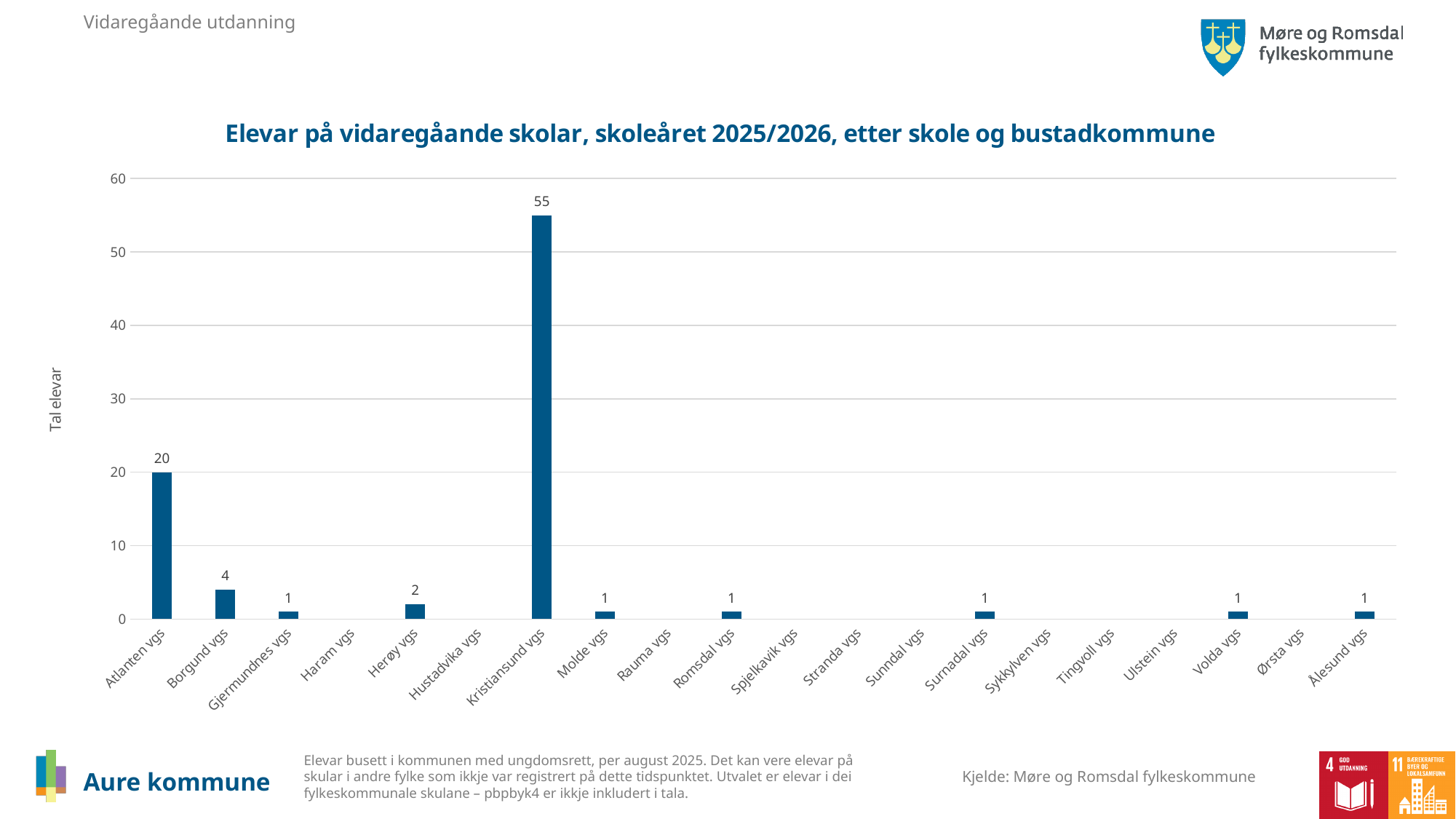
How many schools are listed on the x axis? 20 Which is larger, the value for Borgund vgs or the value for Herøy vgs? Borgund vgs Is the value for Kristiansund vgs greater or less than 50? greater What is the difference between the values for Kristiansund vgs and Atlanten vgs? 35 What is the title of the chart? Elevar på vidaregåande skolar, skoleåret 2025/2026, etter skole og bustadkommune What is the value for Atlanten vgs? 20 What is the label of the y axis? Tal elevar What is the value for Borgund vgs? 4 Which school has the highest number of students? Kristiansund vgs What kind of chart is shown on the slide? bar chart What is the value for Kristiansund vgs? 55 What is the value for Herøy vgs? 2